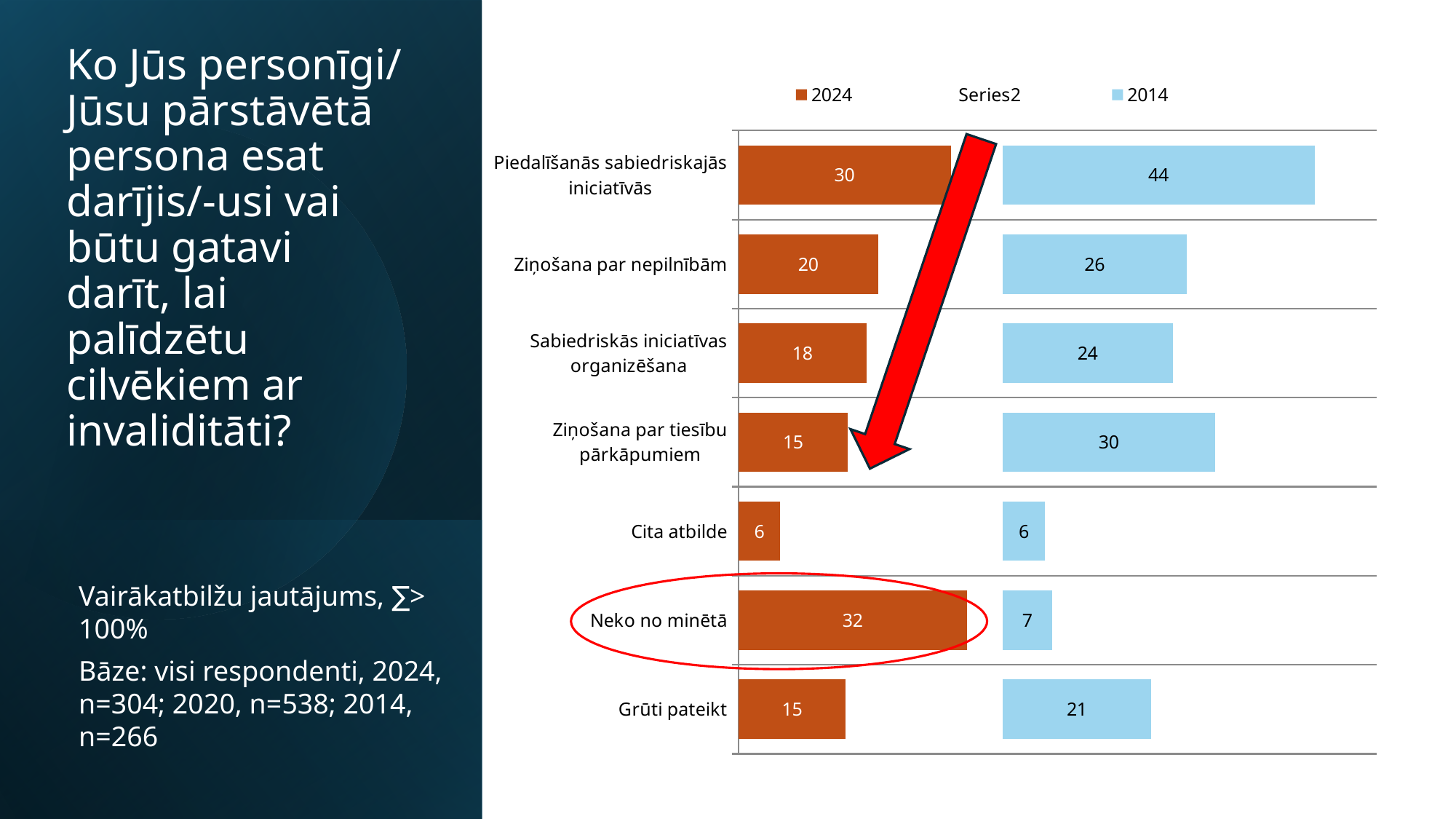
How many categories are shown in the chart? 7 Which category has the highest 2024 value? Neko no minētā How much higher is the 2014 value than the 2024 value for "Piedalīšanās sabiedriskajās iniciatīvās"? 14 What is the 2014 value for "Grūti pateikt"? 21 Which category has the highest 2014 value? Piedalīšanās sabiedriskajās iniciatīvās For "Ziņošana par nepilnībām", which year has the larger value, 2024 or 2014? 2014 What is the difference between the 2024 and 2014 values for "Neko no minētā"? 25 What is the 2014 value for "Ziņošana par tiesību pārkāpumiem"? 30 What colour are the bars for the 2024 series? Orange What is the 2024 value for "Piedalīšanās sabiedriskajās iniciatīvās"? 30 Which category has the lowest 2024 value? Cita atbilde What type of chart is shown on the slide? Bar chart